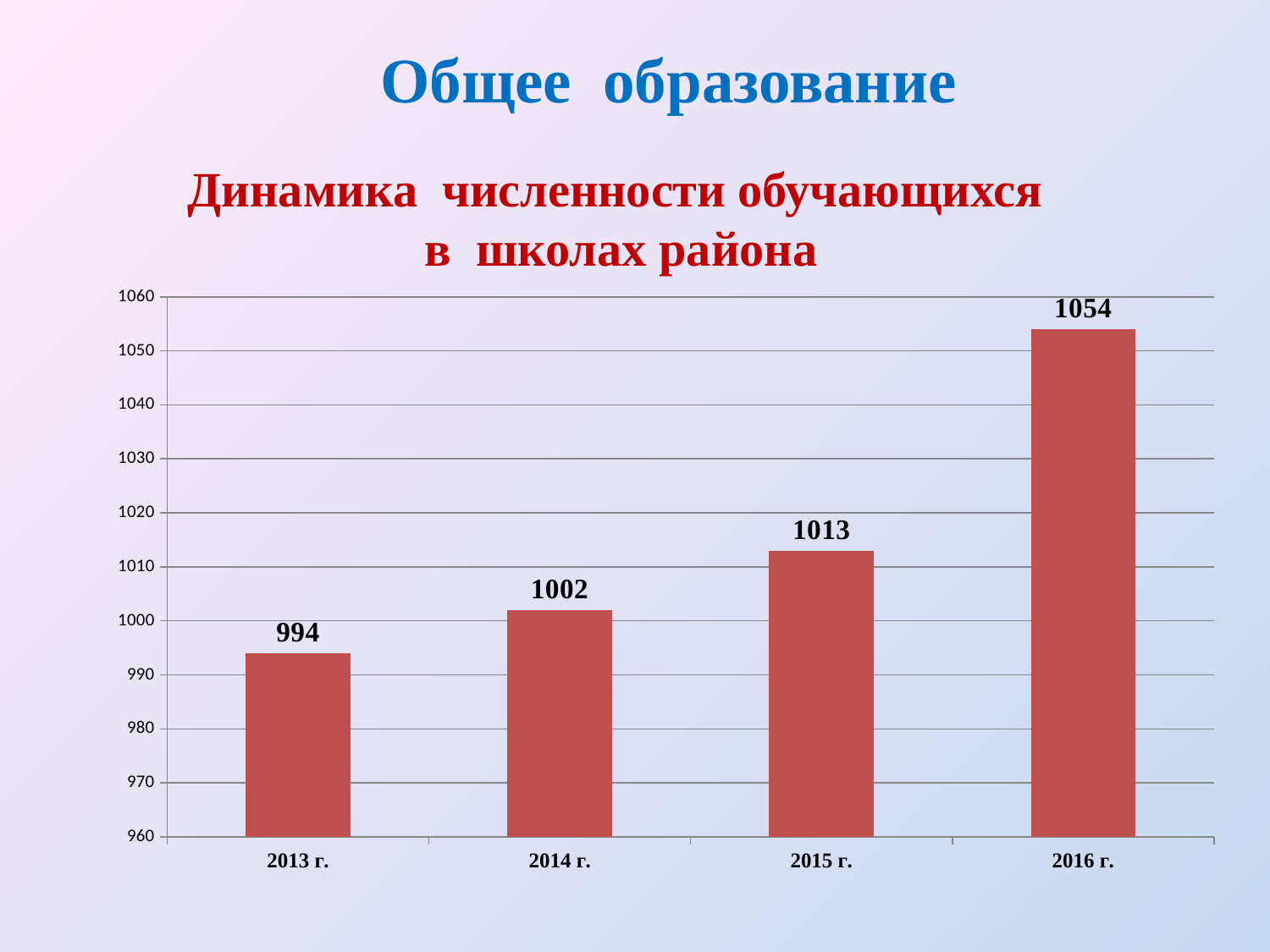
Which is larger, the value for 2014 г. or the value for 2015 г.? 2015 г. Which year has the highest value? 2016 г. What is the value for 2014 г.? 1002 What is the difference between the values for 2016 г. and 2015 г.? 41 How many years are shown on the x axis? 4 Do the values rise or fall from 2013 г. to 2016 г.? rise What kind of chart is shown on the slide? bar chart Which year has the lowest value? 2013 г. What is the value for 2013 г.? 994 What is the difference between the values for 2014 г. and 2013 г.? 8 What is the value for 2016 г.? 1054 What is the value for 2015 г.? 1013